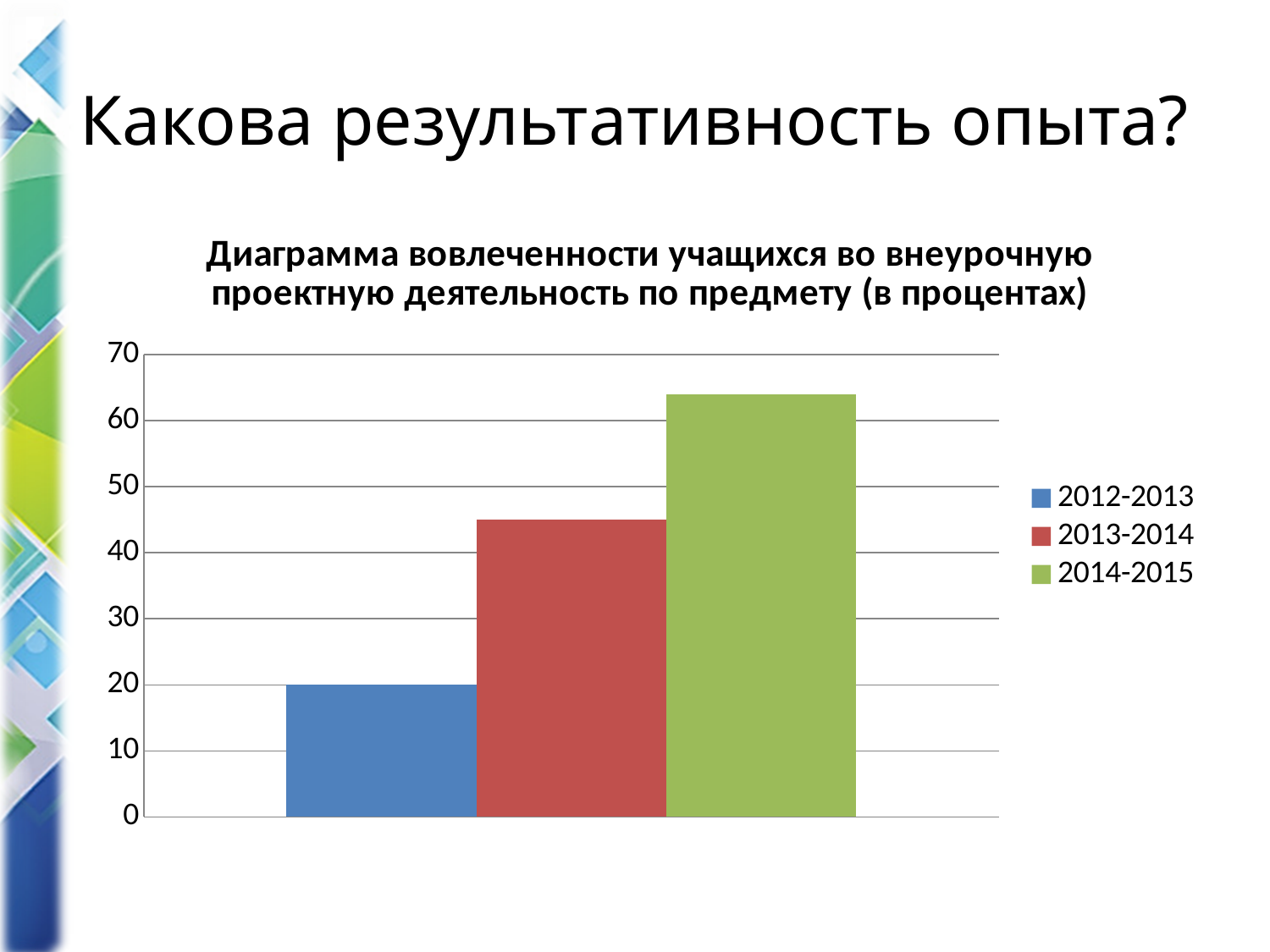
How many series does the legend list? 3 What colour is the bar for 2014-2015? green How many bars are plotted in the chart? 3 What kind of chart is shown on the slide? bar chart Which series has the lowest value? 2012-2013 Is the value for 2013-2014 greater or less than 50? less Which series has the highest value? 2014-2015 Which is larger, the value for 2013-2014 or the value for 2012-2013? 2013-2014 Is the value for 2014-2015 greater or less than 60? greater What is the value for 2012-2013? 20 Do the values rise or fall from 2012-2013 to 2014-2015? rise Is the value for 2013-2014 greater or less than 40? greater